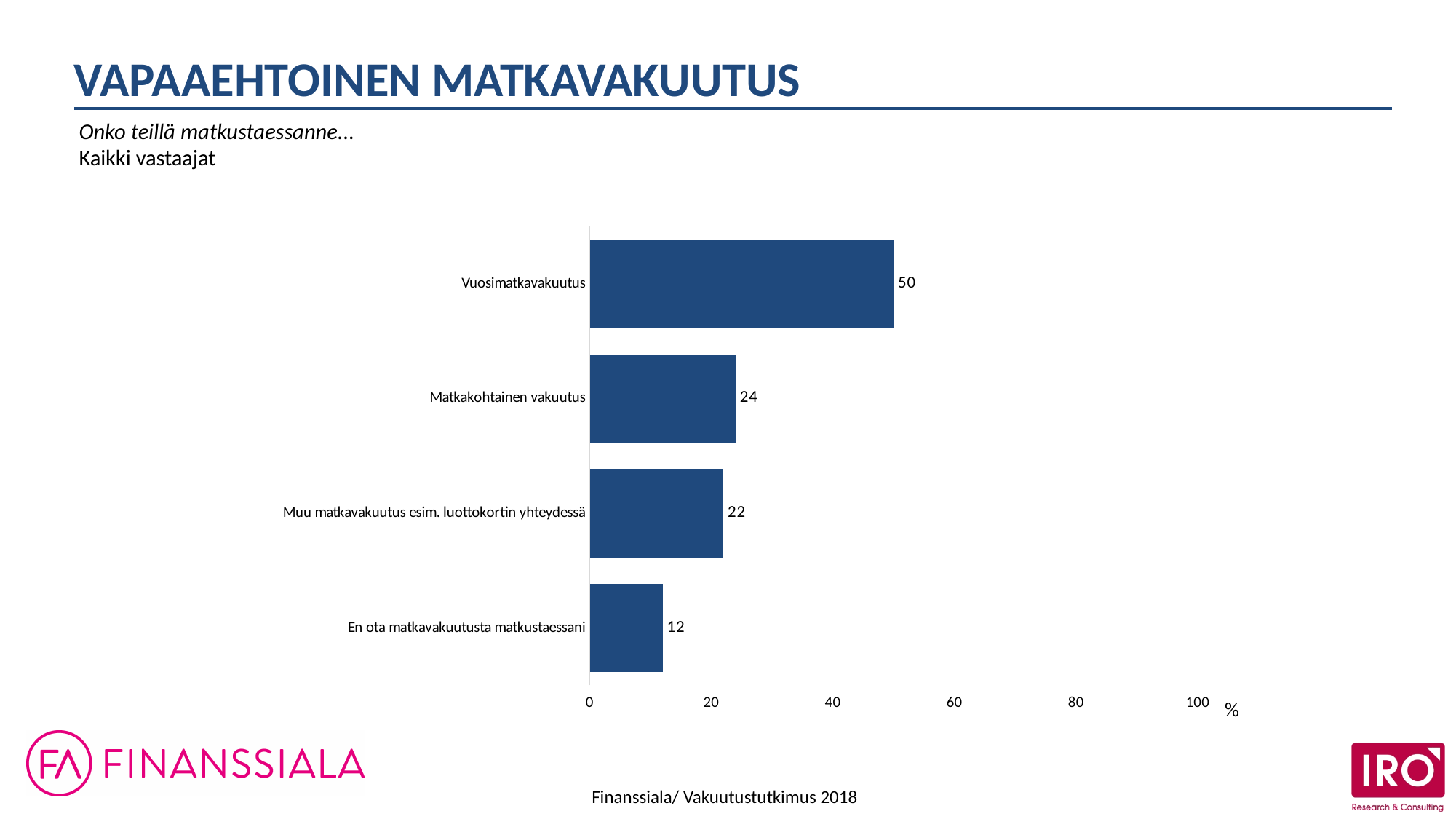
Which category has the lowest value? En ota matkavakuutusta matkustaessani Is the value for Vuosimatkavakuutus greater or less than 40? greater What is the value for Vuosimatkavakuutus? 50 What is the difference between the values for Vuosimatkavakuutus and Matkakohtainen vakuutus? 26 What kind of chart is shown on the slide? bar chart What is the value for Matkakohtainen vakuutus? 24 What is the value for En ota matkavakuutusta matkustaessani? 12 How many categories are shown in the chart? 4 What is the value for Muu matkavakuutus esim. luottokortin yhteydessä? 22 Which category has the highest value? Vuosimatkavakuutus Which is larger, the value for Matkakohtainen vakuutus or the value for En ota matkavakuutusta matkustaessani? Matkakohtainen vakuutus What is the difference between the values for Muu matkavakuutus esim. luottokortin yhteydessä and En ota matkavakuutusta matkustaessani? 10